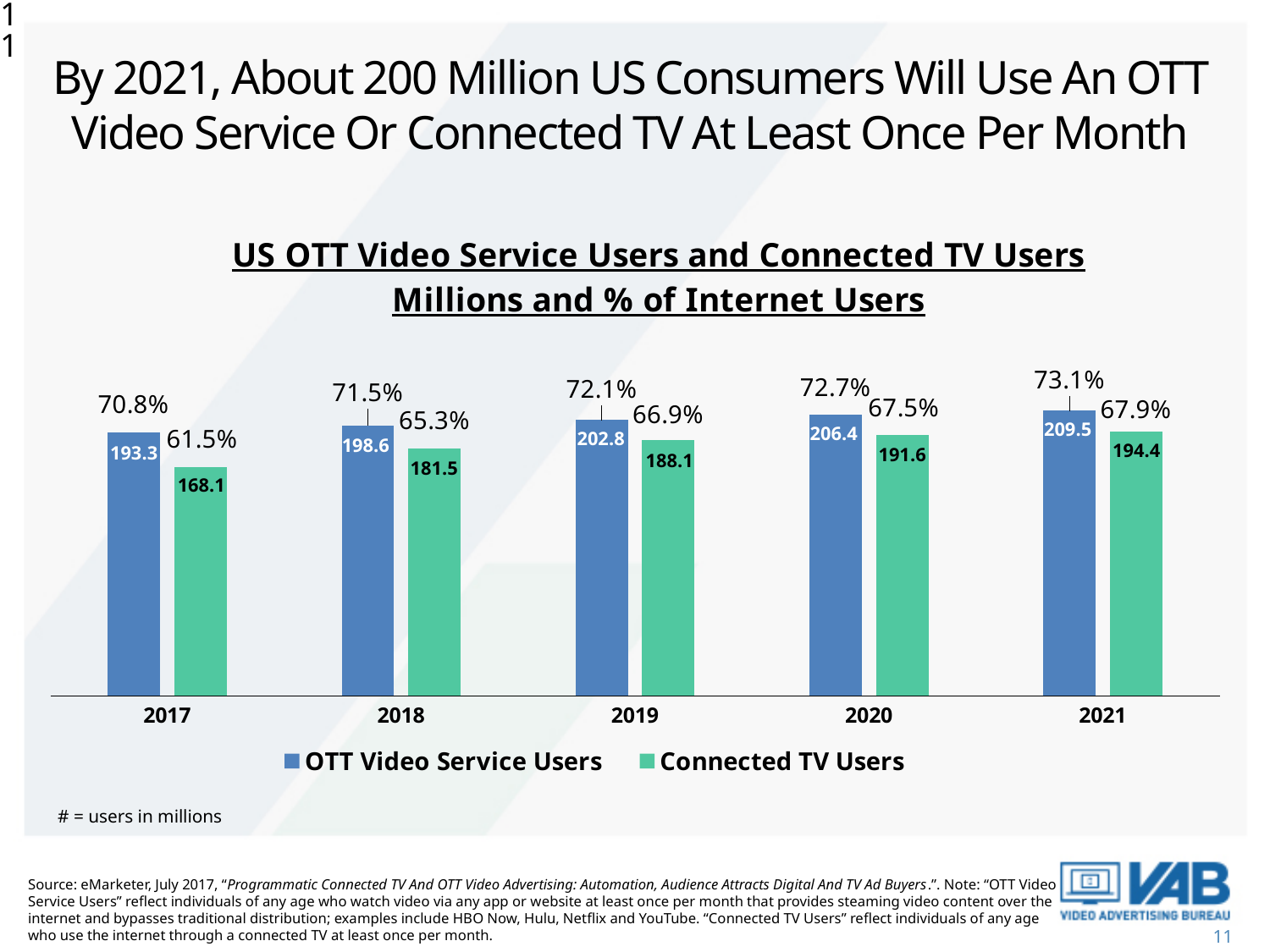
What is the difference between OTT Video Service Users and Connected TV Users in 2018? 17.1 In which year is the OTT Video Service Users value lowest? 2017 What is the value for OTT Video Service Users in 2017? 193.3 How many years are shown on the x axis? 5 What percentage of internet users is shown above the Connected TV Users bar for 2019? 66.9% Which is larger in 2020: OTT Video Service Users or Connected TV Users? OTT Video Service Users In which year is the Connected TV Users value highest? 2021 What is the value for Connected TV Users in 2021? 194.4 Do the Connected TV Users values rise or fall from 2017 to 2021? Rise How many series does the legend list? 2 What percentage of internet users is shown above the OTT Video Service Users bar for 2020? 72.7% What kind of chart is shown? Bar chart